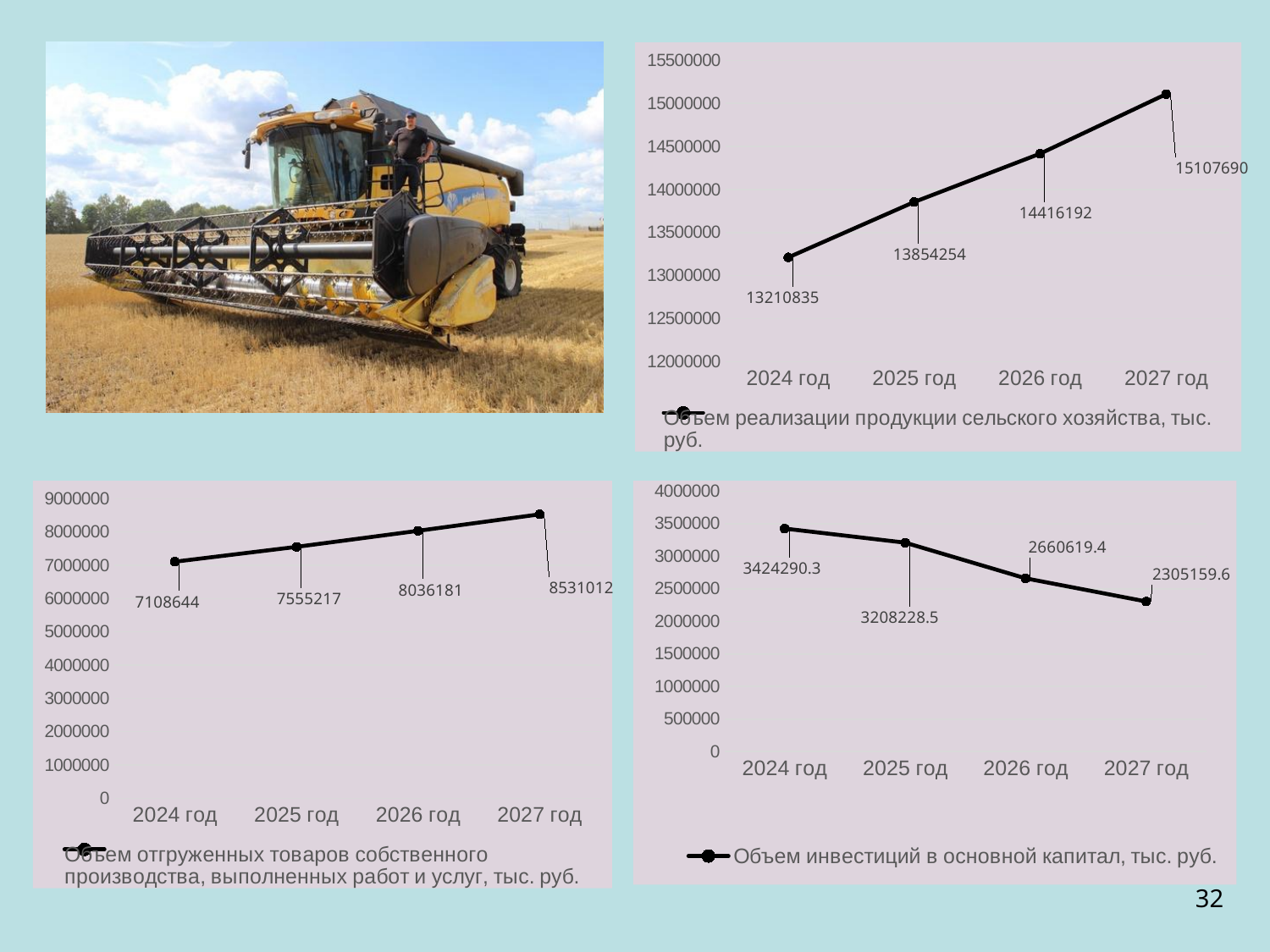
In the bottom-left chart (Объем отгруженных товаров собственного производства), what is the difference between the 2025 год and 2024 год values? 446573 In the top-right chart (Объем реализации продукции сельского хозяйства), what is the difference between the 2027 год and 2024 год values? 1896855 What type of chart is the top-right chart (Объем реализации продукции сельского хозяйства)? line chart In the bottom-right chart (Объем инвестиций в основной капитал), what is the value for 2024 год? 3424290.3 In the top-right chart (Объем реализации продукции сельского хозяйства), do the values rise or fall from 2024 год to 2027 год? rise In the bottom-left chart (Объем отгруженных товаров собственного производства), which year has the lowest value? 2024 год In the bottom-right chart (Объем инвестиций в основной капитал), which is larger, the value for 2026 год or 2027 год? 2026 год In the top-right chart (Объем реализации продукции сельского хозяйства), which year has the highest value? 2027 год In the bottom-right chart (Объем инвестиций в основной капитал), do the values rise or fall from 2024 год to 2027 год? fall How many data points are plotted in the bottom-right chart (Объем инвестиций в основной капитал)? 4 In the top-right chart (Объем реализации продукции сельского хозяйства), what is the value for 2025 год? 13854254 In the bottom-left chart (Объем отгруженных товаров собственного производства), what is the value for 2026 год? 8036181